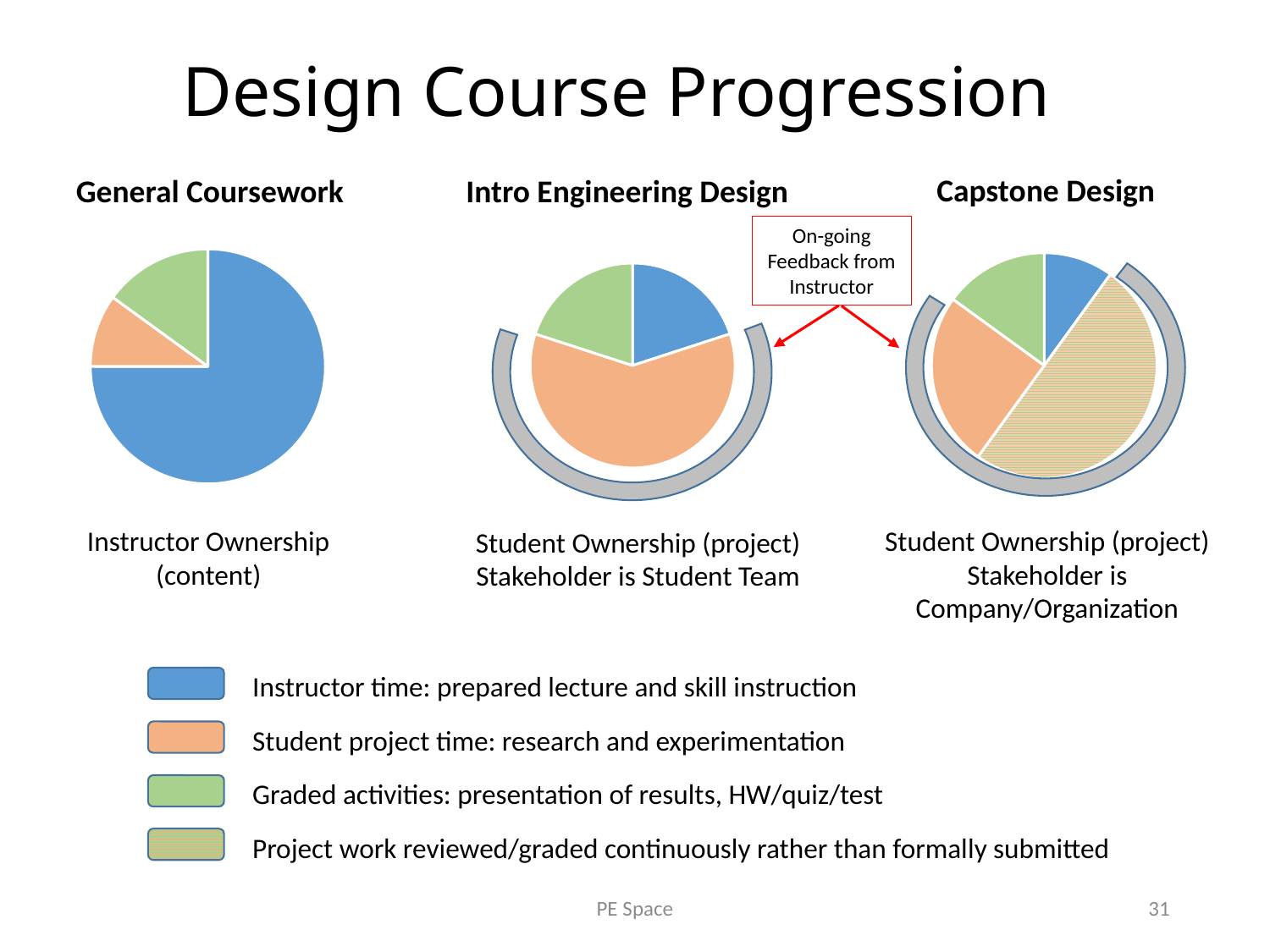
In the General Coursework pie chart, which category has the smallest slice? Student project time: research and experimentation What kind of chart is used for the General Coursework chart? pie chart In the Capstone Design pie chart, which is larger: the Instructor time slice or the Student project time slice? Student project time How many slices does the General Coursework pie chart have? 3 How many entries does the legend at the bottom of the slide list? 4 In the Capstone Design pie chart, which category has the smallest slice? Instructor time: prepared lecture and skill instruction In the Capstone Design pie chart, which category has the largest slice? Project work reviewed/graded continuously rather than formally submitted In the Intro Engineering Design pie chart, which is larger: the Instructor time slice or the Student project time slice? Student project time How many slices does the Capstone Design pie chart have? 4 In the General Coursework pie chart, which category has the largest slice? Instructor time: prepared lecture and skill instruction In the Intro Engineering Design pie chart, which category has the largest slice? Student project time: research and experimentation What colour represents 'Graded activities: presentation of results, HW/quiz/test' in the legend? green